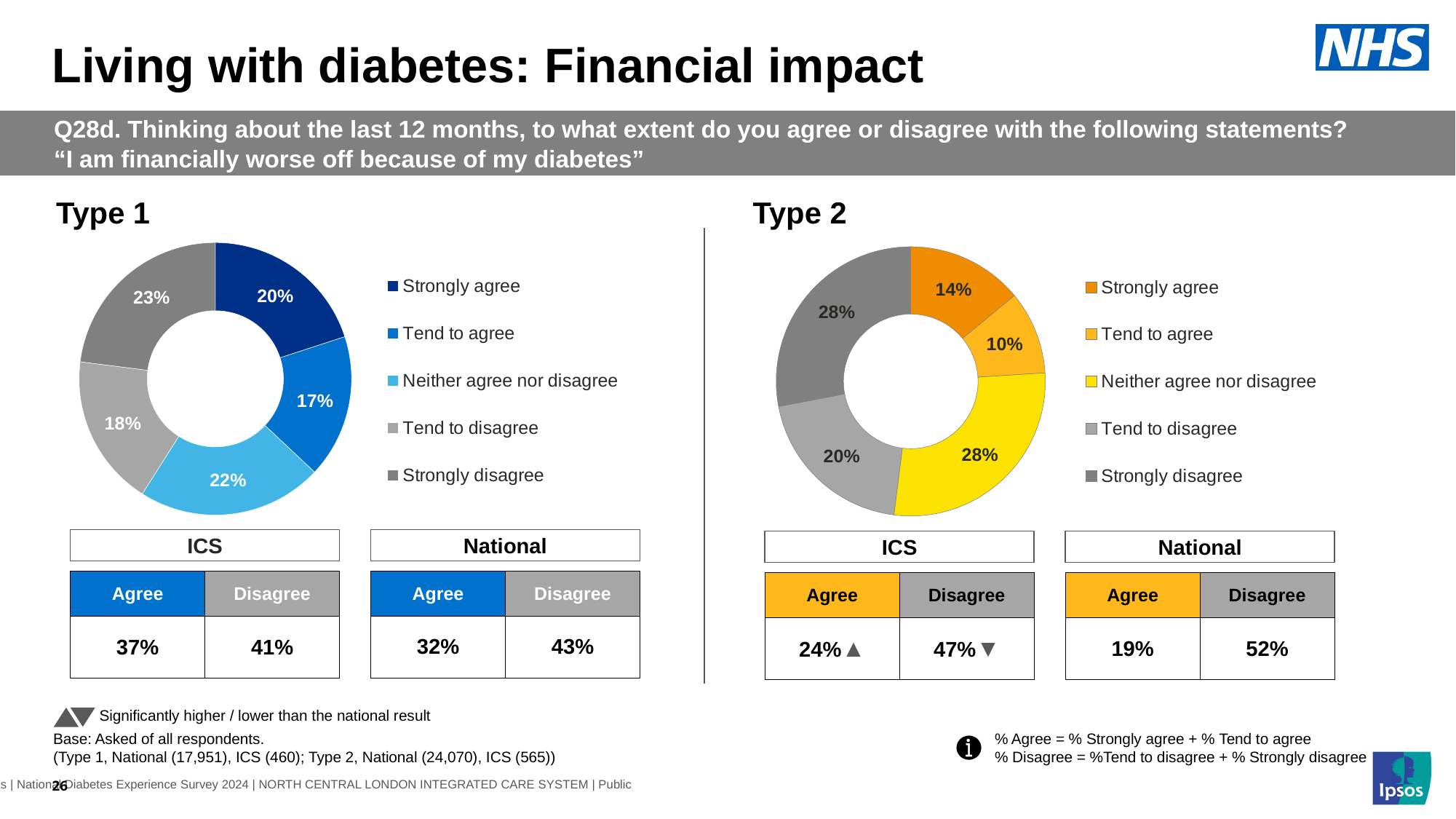
In the Type 2 chart, which response category has the smallest share? Tend to agree In the Type 1 chart, which is larger: the share for Tend to disagree or the share for Strongly agree? Strongly agree In the Type 2 chart, what percentage of respondents said they tend to agree? 10% In the Type 1 chart, what percentage of respondents said they strongly agree? 20% In the Type 2 chart, what percentage of respondents said they tend to disagree? 20% In the Type 2 chart, what colour represents Neither agree nor disagree? Yellow In the Type 1 chart, which response category has the smallest share? Tend to agree In the Type 2 chart, what is the difference in percentage points between Strongly disagree and Strongly agree? 14 How many response categories does the Type 2 chart's legend list? 5 What kind of chart is used for the Type 1 data? Donut (pie) chart In the Type 1 chart, which response category has the largest share? Strongly disagree In the Type 1 chart, what percentage of respondents said they neither agree nor disagree? 22%